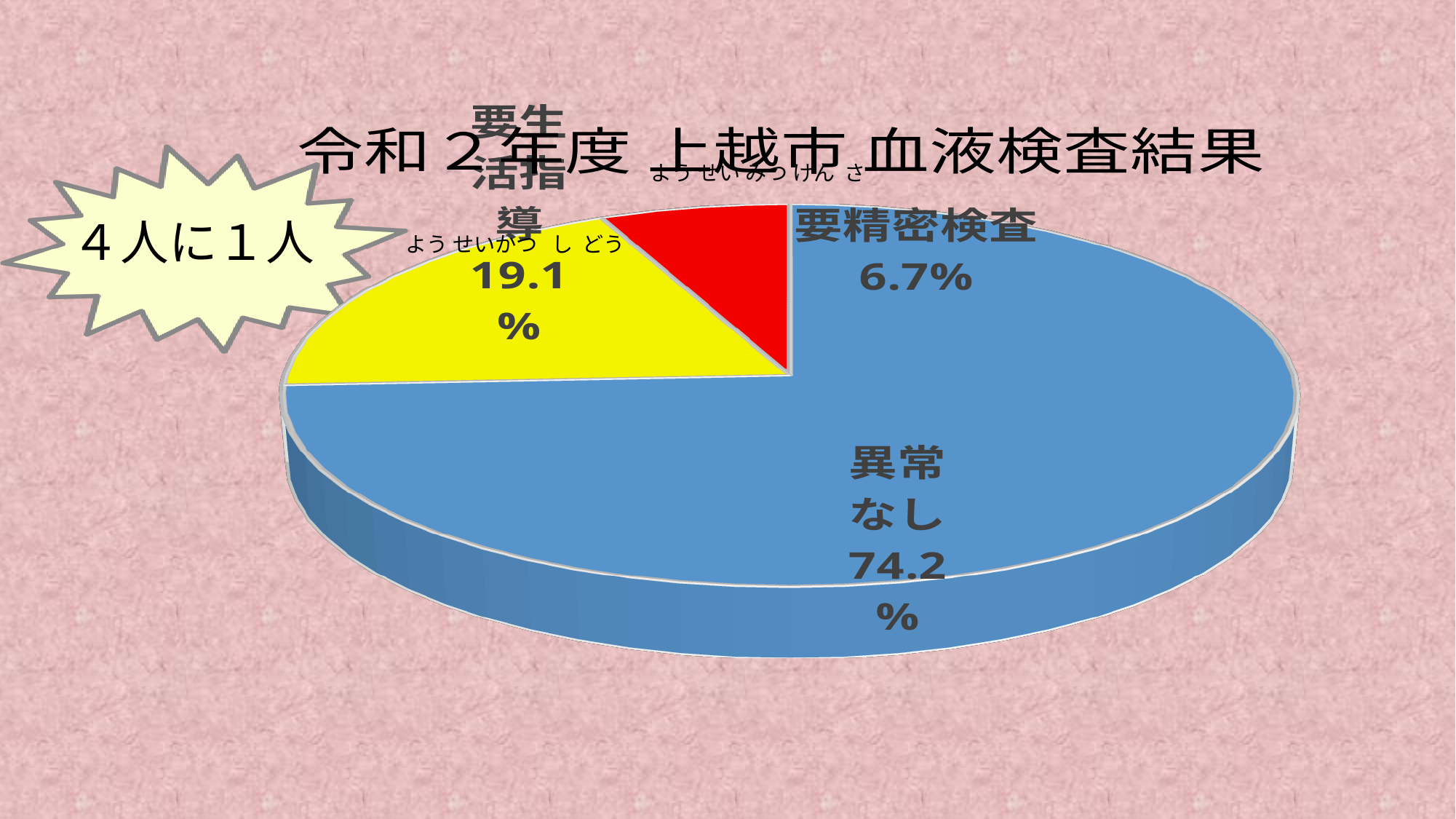
How many slices does the pie chart have? 3 What percentage is shown for 異常なし? 74.2% What colour is the slice for 要精密検査? red What percentage is shown for 要生活指導? 19.1% What is the difference in percentage points between 異常なし and 要生活指導? 55.1 Which category has the largest share of the pie? 異常なし What is the difference in percentage points between 要生活指導 and 要精密検査? 12.4 Which is larger, the share for 要生活指導 or the share for 要精密検査? 要生活指導 What is the title of the chart? 令和２年度 上越市 血液検査結果 What percentage is shown for 要精密検査? 6.7% What kind of chart is shown on the slide? pie chart Which category has the smallest share of the pie? 要精密検査